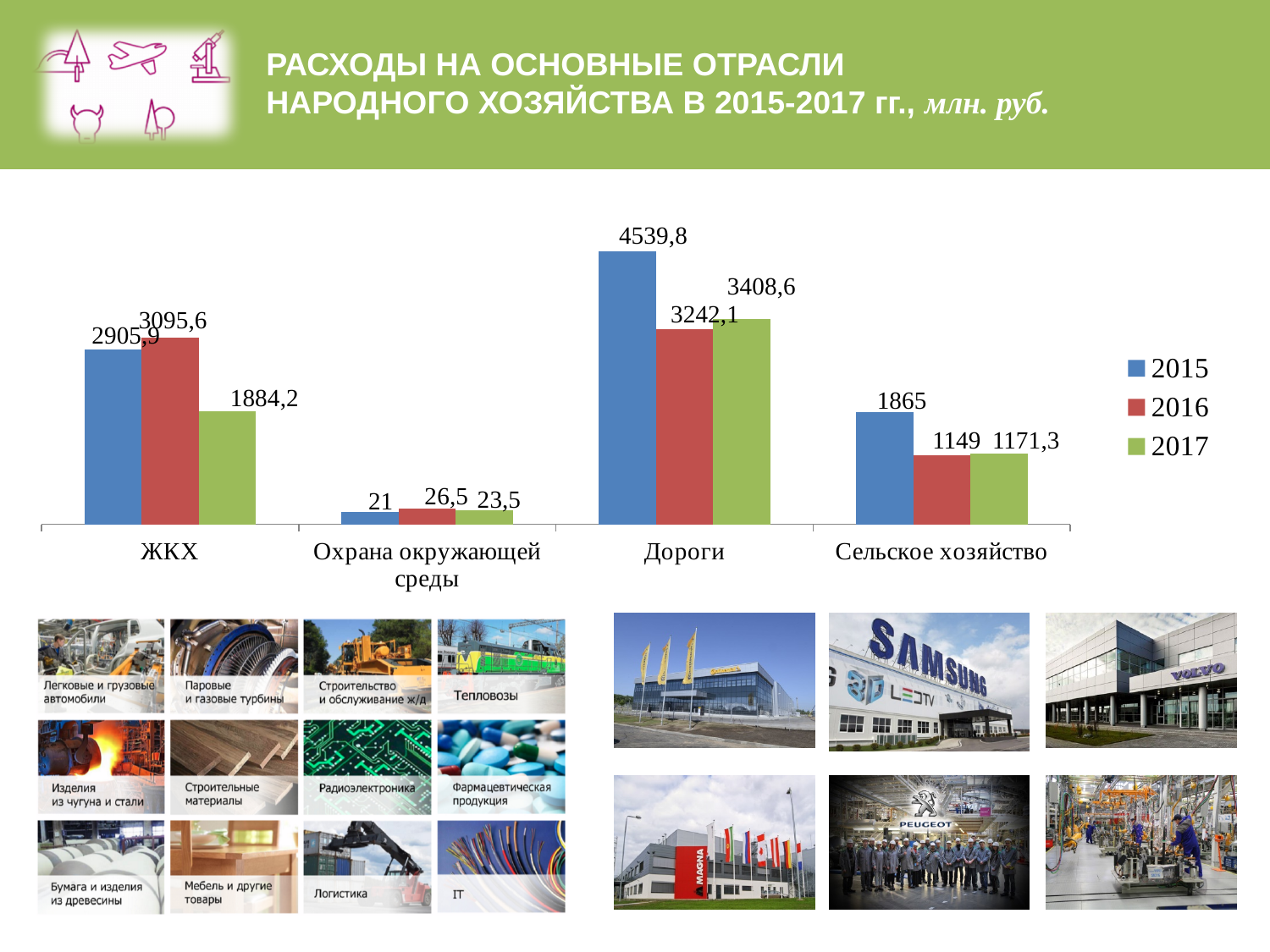
What kind of chart is shown on the slide? Bar chart What is the difference between the 2016 and 2017 values for ЖКХ? 1211,4 What is the value for Охрана окружающей среды in 2016? 26,5 What is the difference between the 2015 and 2016 values for Дороги? 1297,7 What is the value for Дороги in 2015? 4539,8 Which is larger for Сельское хозяйство: the 2015 value or the 2017 value? 2015 How many series does the legend list? 3 Which category has the lowest value in 2017? Охрана окружающей среды How many categories are shown on the x axis? 4 Which category has the highest value in 2015? Дороги What is the value for ЖКХ in 2017? 1884,2 What is the value for Сельское хозяйство in 2016? 1149